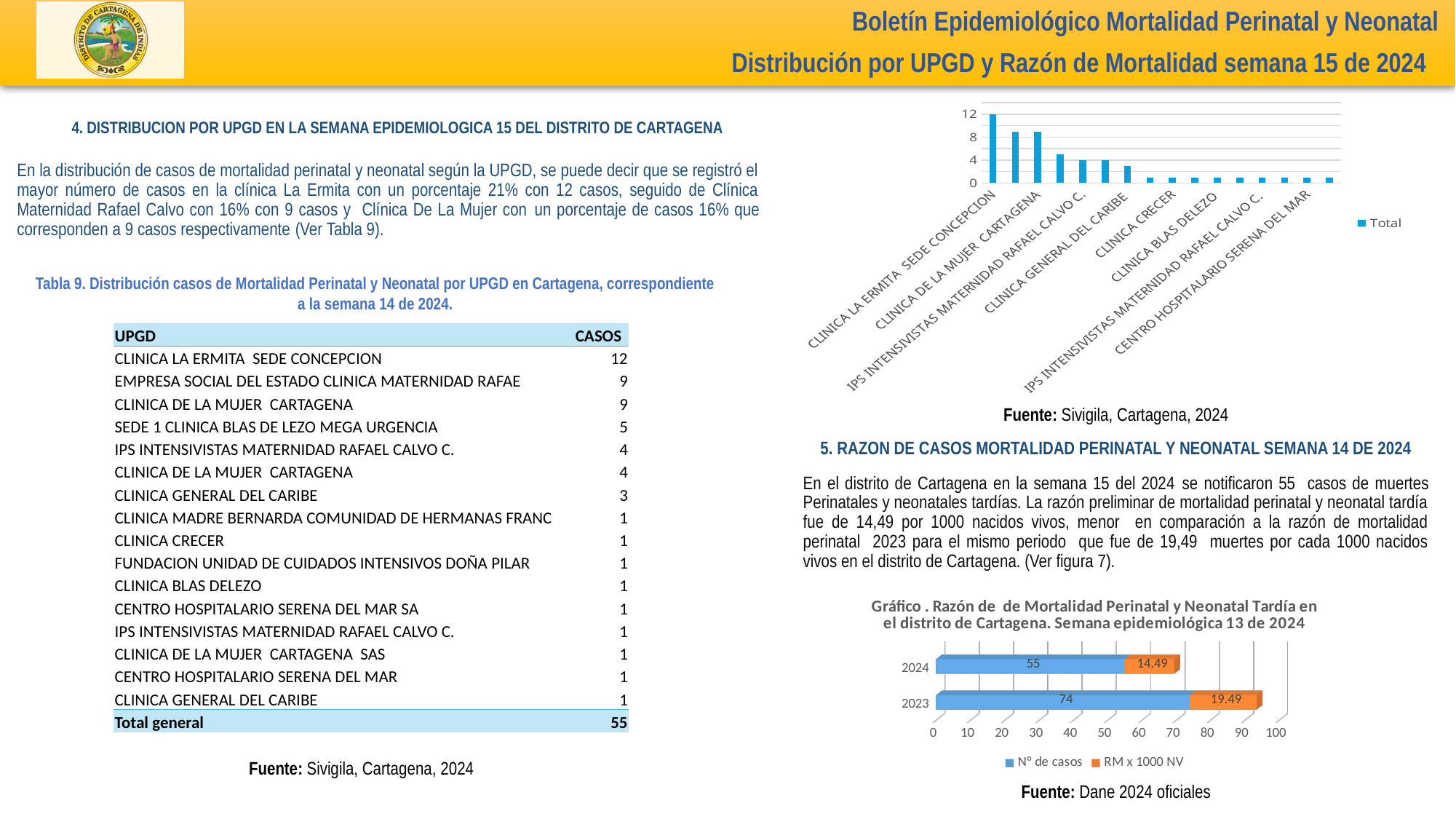
In the bottom-right chart (Razón de Mortalidad Perinatal y Neonatal Tardía), which year has the larger RM x 1000 NV value, 2023 or 2024? 2023 What kind of chart is the top-right chart? bar chart In the bottom-right chart (Razón de Mortalidad Perinatal y Neonatal Tardía), what is the N° de casos value for 2024? 55 In the top-right chart, is the value for CLINICA LA ERMITA SEDE CONCEPCION greater or less than 8? greater In the bottom-right chart (Razón de Mortalidad Perinatal y Neonatal Tardía), how many series does the legend list? 2 In the top-right chart, which category has the highest bar? CLINICA LA ERMITA SEDE CONCEPCION In the top-right chart, how many series does the legend list? 1 In the bottom-right chart (Razón de Mortalidad Perinatal y Neonatal Tardía), what is the total of the stacked bar for 2024? 69.49 In the bottom-right chart (Razón de Mortalidad Perinatal y Neonatal Tardía), what is the RM x 1000 NV value for 2023? 19.49 In the bottom-right chart (Razón de Mortalidad Perinatal y Neonatal Tardía), what is the difference in N° de casos between 2023 and 2024? 19 In the top-right chart, is the value for CLINICA CRECER greater or less than 4? less In the top-right chart, what is the name of the series shown in the legend? Total